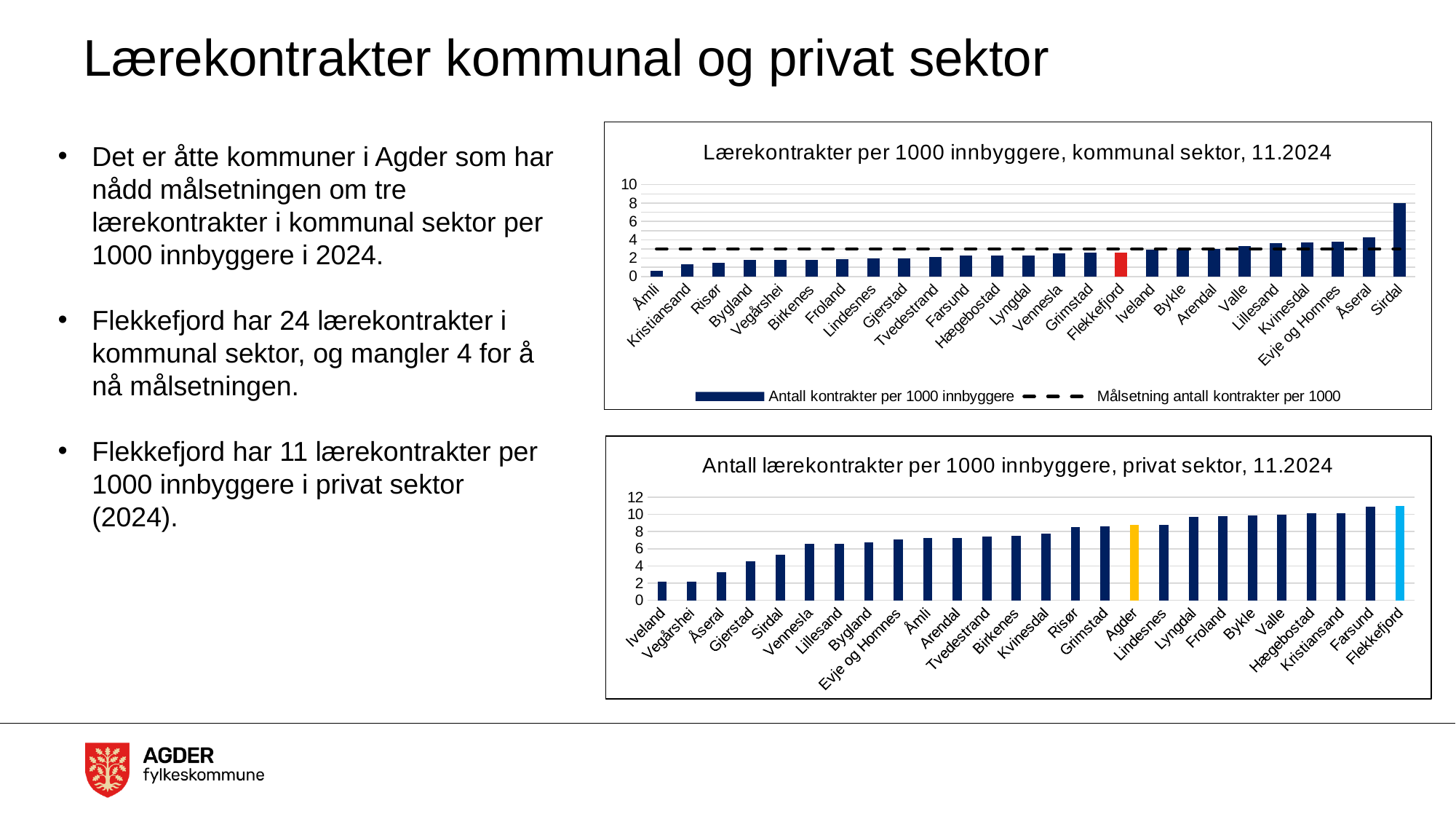
In the top chart (kommunal sektor), which municipality has the highest number of contracts per 1000 inhabitants? Sirdal In the bottom chart (privat sektor), is the value for Flekkefjord greater or less than 10? greater In the top chart (kommunal sektor), what colour is the bar for Flekkefjord? Red In the bottom chart (privat sektor), do the values rise or fall from left to right along the x axis? Rise In the top chart (kommunal sektor), is the value for Sirdal greater or less than 6? greater In the bottom chart (privat sektor), which municipality has the highest number of contracts per 1000 inhabitants? Flekkefjord How many municipalities are shown on the x axis of the top chart (kommunal sektor)? 25 What kind of chart is the top chart, 'Lærekontrakter per 1000 innbyggere, kommunal sektor, 11.2024'? Bar chart In the top chart (kommunal sektor), which municipality has the lowest number of contracts per 1000 inhabitants? Åmli In the top chart (kommunal sektor), is the value for Åmli greater or less than 2? less How many series does the legend of the top chart (kommunal sektor) list? 2 In the bottom chart (privat sektor), which is larger, the value for Iveland or the value for Farsund? Farsund